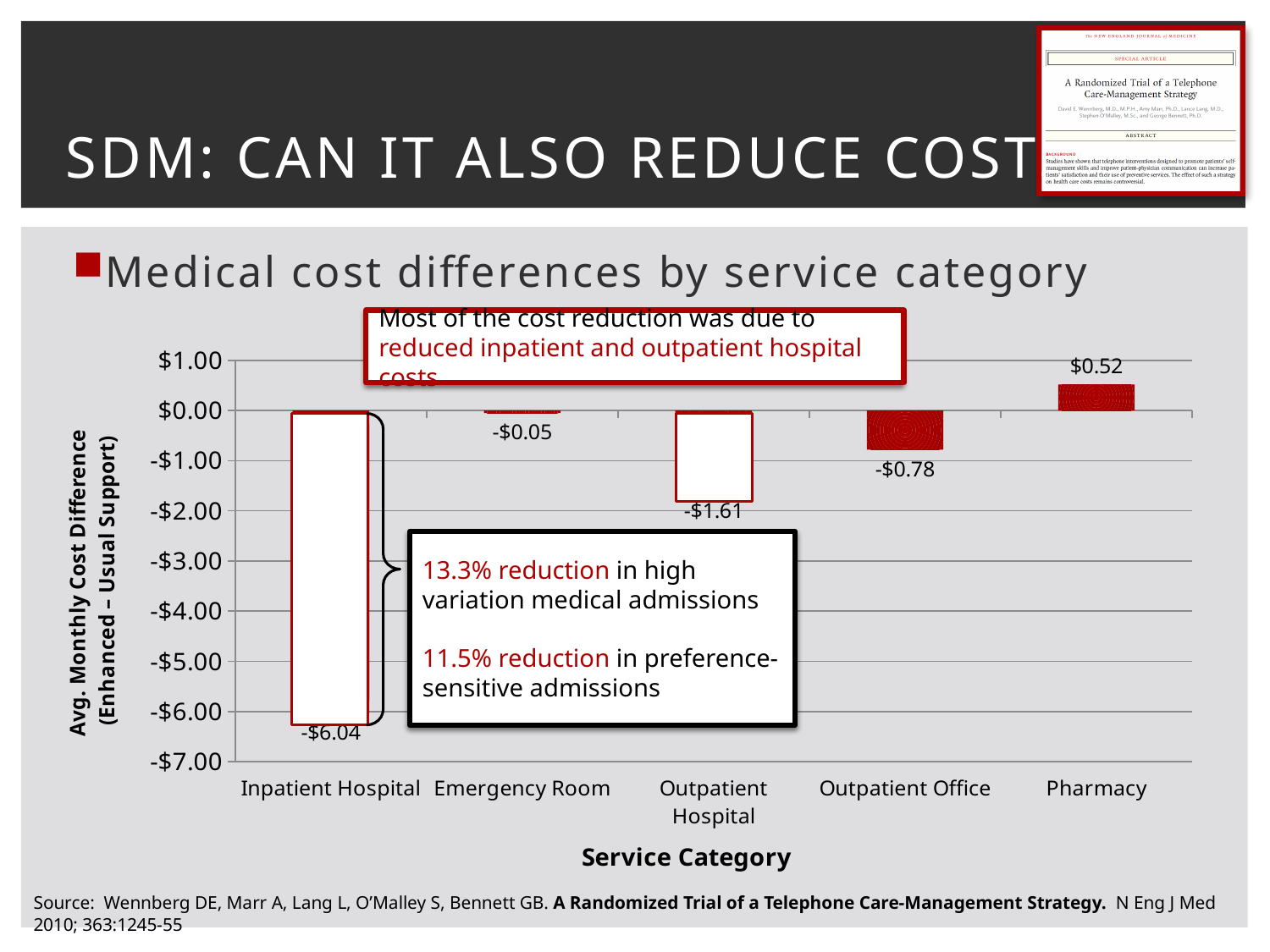
What kind of chart is used to show the medical cost differences? Bar chart How many service categories are shown on the x axis? 5 What is the average monthly cost difference for Emergency Room? -$0.05 What is the average monthly cost difference for Pharmacy? $0.52 Which service category has the highest average monthly cost difference? Pharmacy Which has a larger cost reduction, Outpatient Hospital or Outpatient Office? Outpatient Hospital Is the value for Inpatient Hospital greater or less than -$5.00? less What is the average monthly cost difference for Inpatient Hospital? -$6.04 What is the difference between the Outpatient Hospital value (-$1.61) and the Outpatient Office value (-$0.78)? $0.83 What is the label of the x axis? Service Category Which service category has the lowest (most negative) average monthly cost difference? Inpatient Hospital What is the average monthly cost difference for Outpatient Hospital? -$1.61